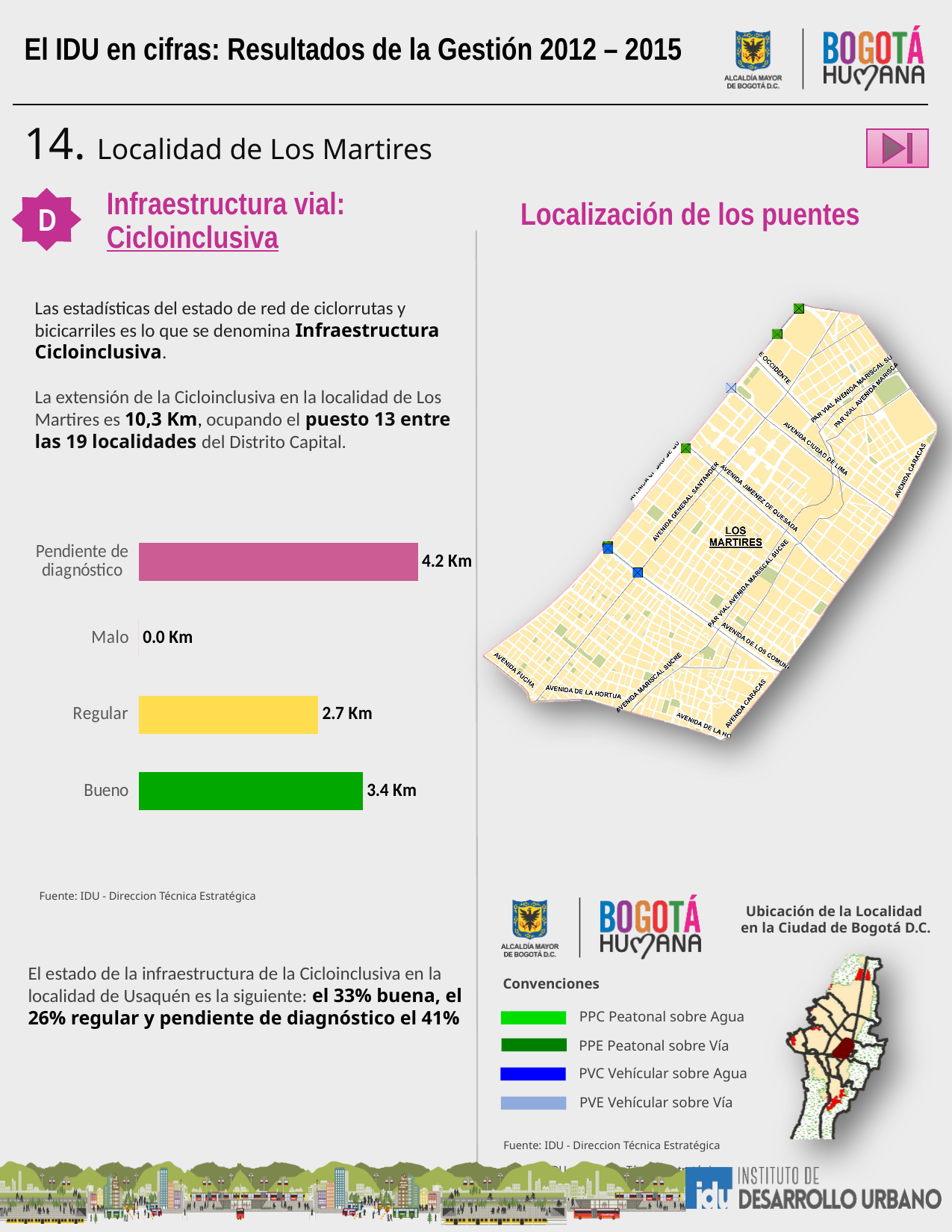
How many categories are shown in the bar chart? 4 What is the value for Pendiente de diagnóstico in the bar chart? 4.2 Km Which is larger, the value for Bueno or the value for Regular? Bueno What is the value for Regular in the bar chart? 2.7 Km What is the difference between the values for Bueno and Regular? 0.7 Km Which category has the lowest value in the bar chart? Malo What colour is the bar for Bueno in the chart? Green What is the value for Bueno in the bar chart? 3.4 Km What kind of chart is shown on the left side of the slide? Bar chart What is the value for Malo in the bar chart? 0.0 Km What is the difference between the values for Pendiente de diagnóstico and Bueno? 0.8 Km Which category has the highest value in the bar chart? Pendiente de diagnóstico